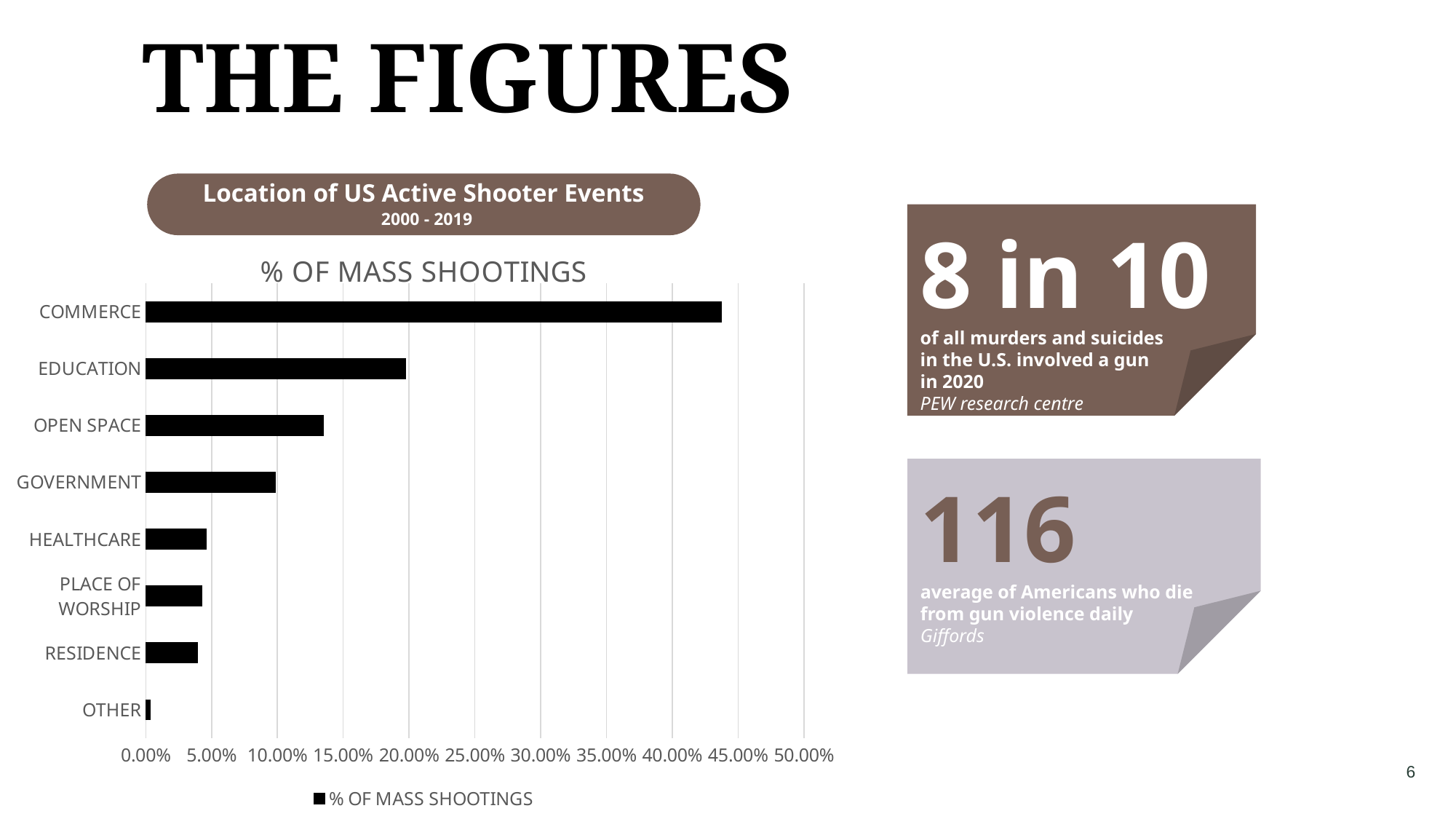
What kind of chart is shown on the slide? Bar chart What is the title shown above the chart's plot area? % OF MASS SHOOTINGS Which location category has the lowest % of mass shootings? OTHER Which has a larger % of mass shootings, EDUCATION or GOVERNMENT? EDUCATION Is the value for COMMERCE greater or less than 40.00%? greater Is the value for EDUCATION greater or less than 15.00%? greater Which location category has the highest % of mass shootings? COMMERCE Which has a larger % of mass shootings, OPEN SPACE or HEALTHCARE? OPEN SPACE How many series does the chart legend list? 1 Is the value for OPEN SPACE greater or less than 10.00%? greater How many location categories are plotted in the chart? 8